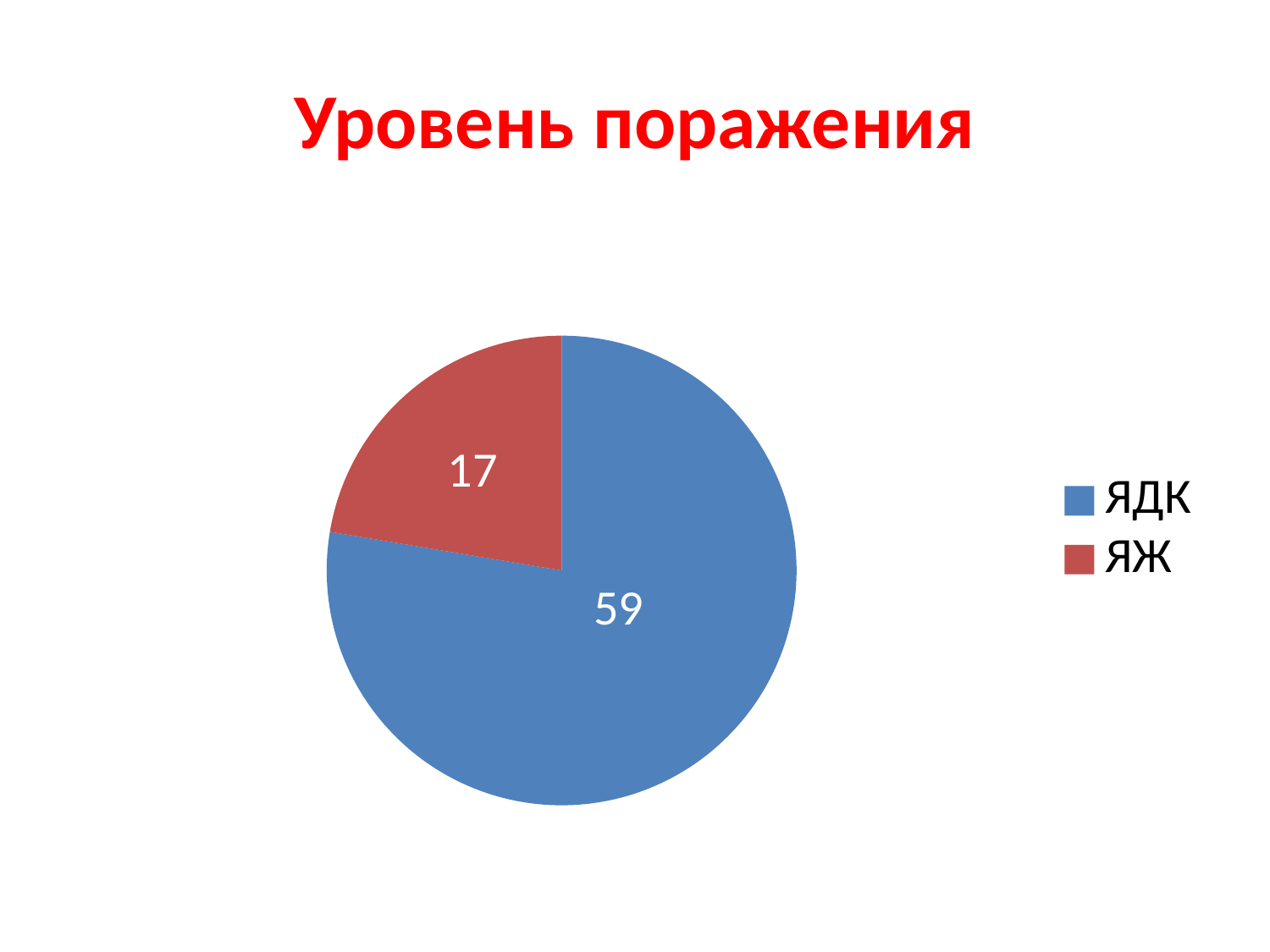
What type of chart is shown on the slide? pie chart How many slices does the pie chart have? 2 Which category has the largest slice of the pie? ЯДК Which is larger, the value for ЯДК or the value for ЯЖ? ЯДК What is the value for ЯЖ? 17 What is the sum of the two slice values in the pie chart? 76 How many entries does the legend list? 2 Which category has the smallest slice of the pie? ЯЖ What is the difference between the values for ЯДК and ЯЖ? 42 What is the title of the slide? Уровень поражения What colour is the slice for ЯЖ? red What is the value for ЯДК? 59